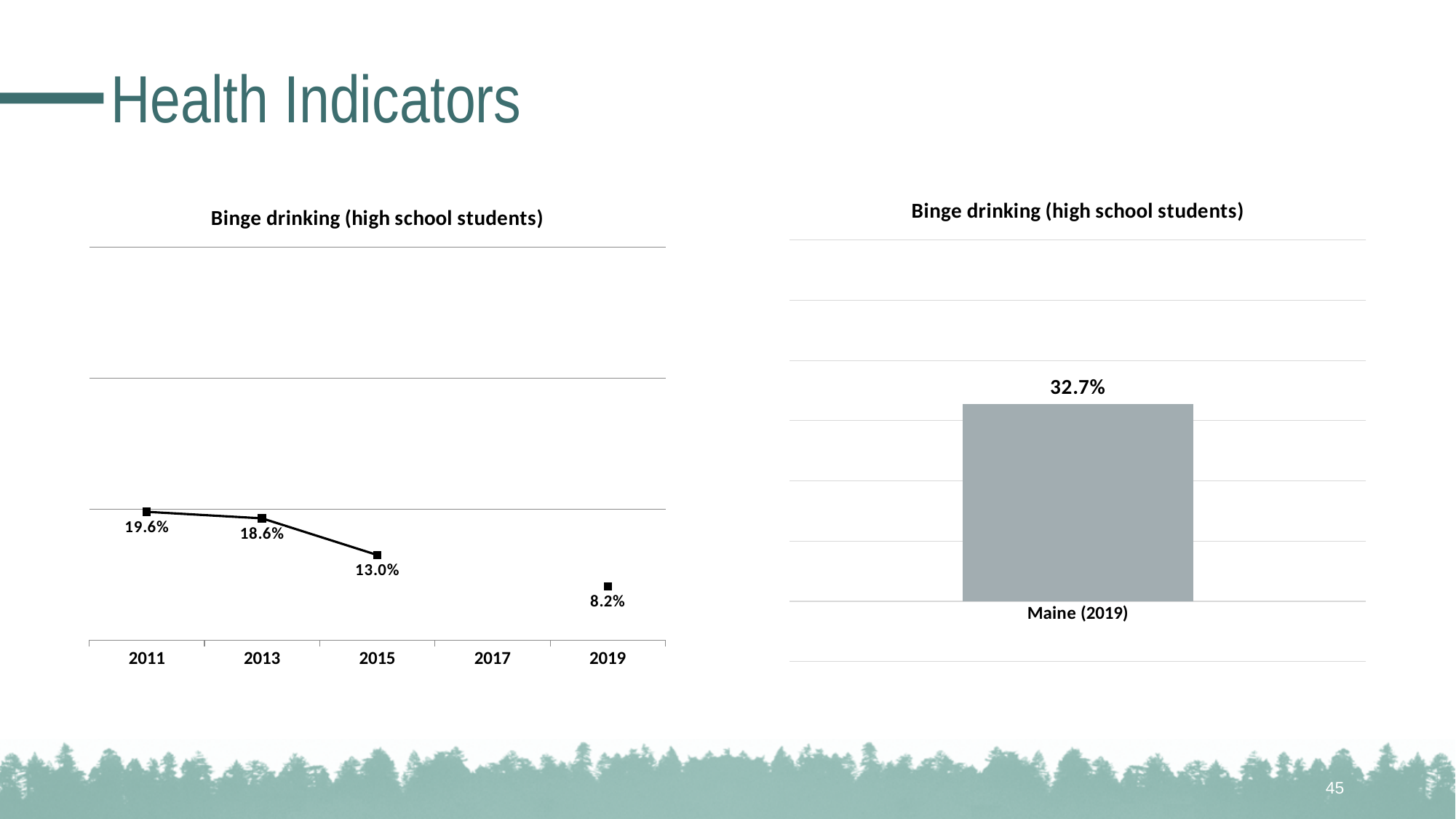
On the left chart, which year has the lowest binge drinking value? 2019 On the left chart, what is the difference between the 2011 and 2019 values? 11.4% On the left chart, how many years are labelled on the x axis? 5 On the left chart, what is the binge drinking value for 2015? 13.0% On the left chart, what is the binge drinking value for 2011? 19.6% On the left chart, which is larger, the value for 2013 or the value for 2015? 2013 On the left chart, do the values rise or fall from 2011 to 2019? fall What kind of chart is the right chart? bar chart What kind of chart is the left chart? line chart On the left chart, what is the binge drinking value for 2019? 8.2% On the left chart, which year has the highest binge drinking value? 2011 On the right chart, what is the binge drinking value for Maine (2019)? 32.7%